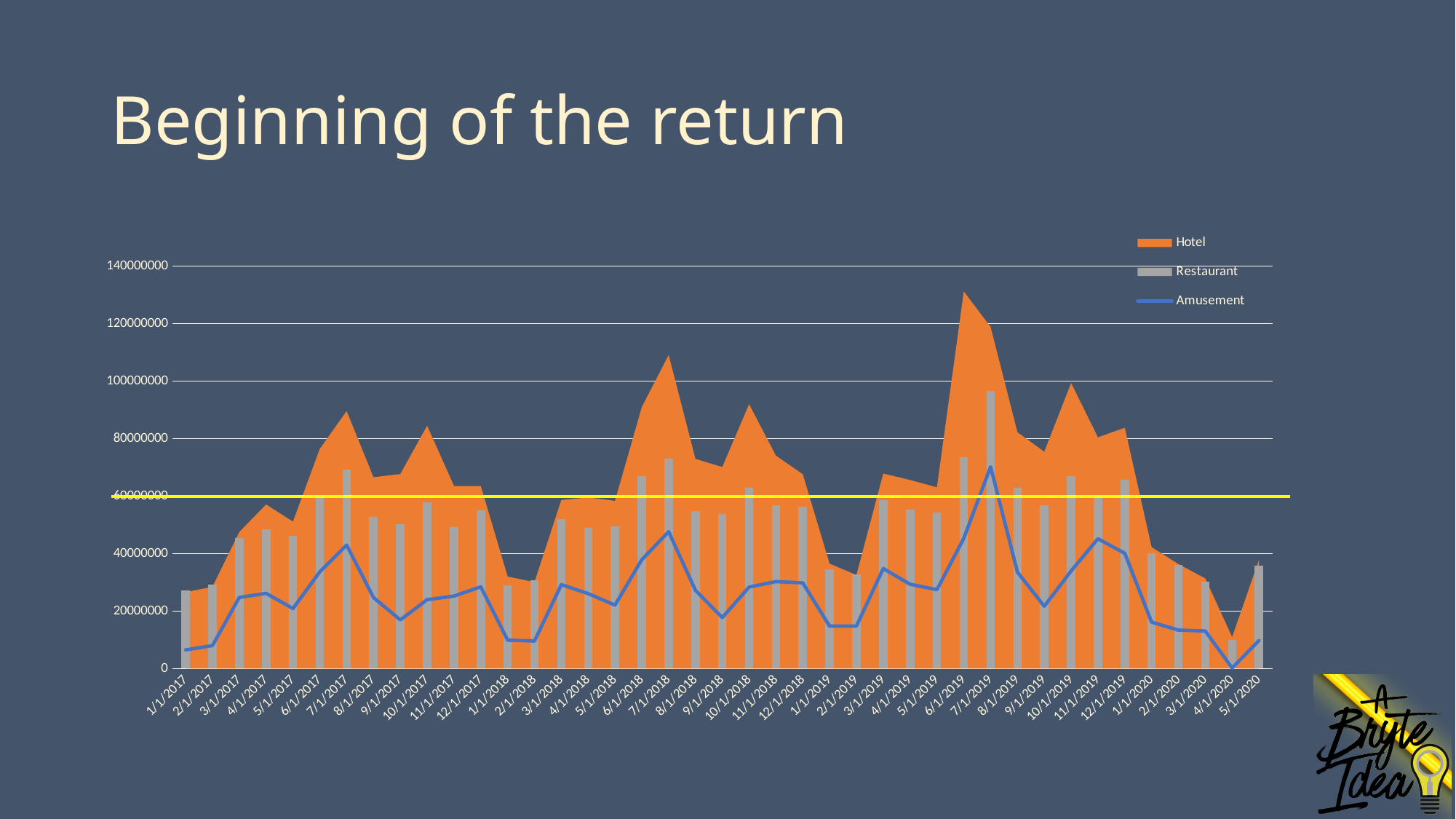
How many monthly dates are shown on the x axis of the chart? 41 What are the three series named in the chart legend? Hotel, Restaurant, Amusement Is the Amusement value for 1/1/2017 greater or less than 20000000? less Is the Hotel value for 6/1/2019 greater or less than 120000000? greater Is the Restaurant value for 7/1/2019 greater or less than 80000000? greater At which date does the Amusement series reach its lowest value? 4/1/2020 At which date does the Restaurant series reach its highest value? 7/1/2019 Does the Hotel series rise or fall from 12/1/2019 to 4/1/2020? fall What kind of chart is shown on the slide? A combination chart with an area series, a bar series and a line series How many series does the chart legend list? 3 At which date does the Hotel series reach its highest value? 6/1/2019 Which is larger, the Hotel value for 6/1/2019 or the Hotel value for 7/1/2018? 6/1/2019